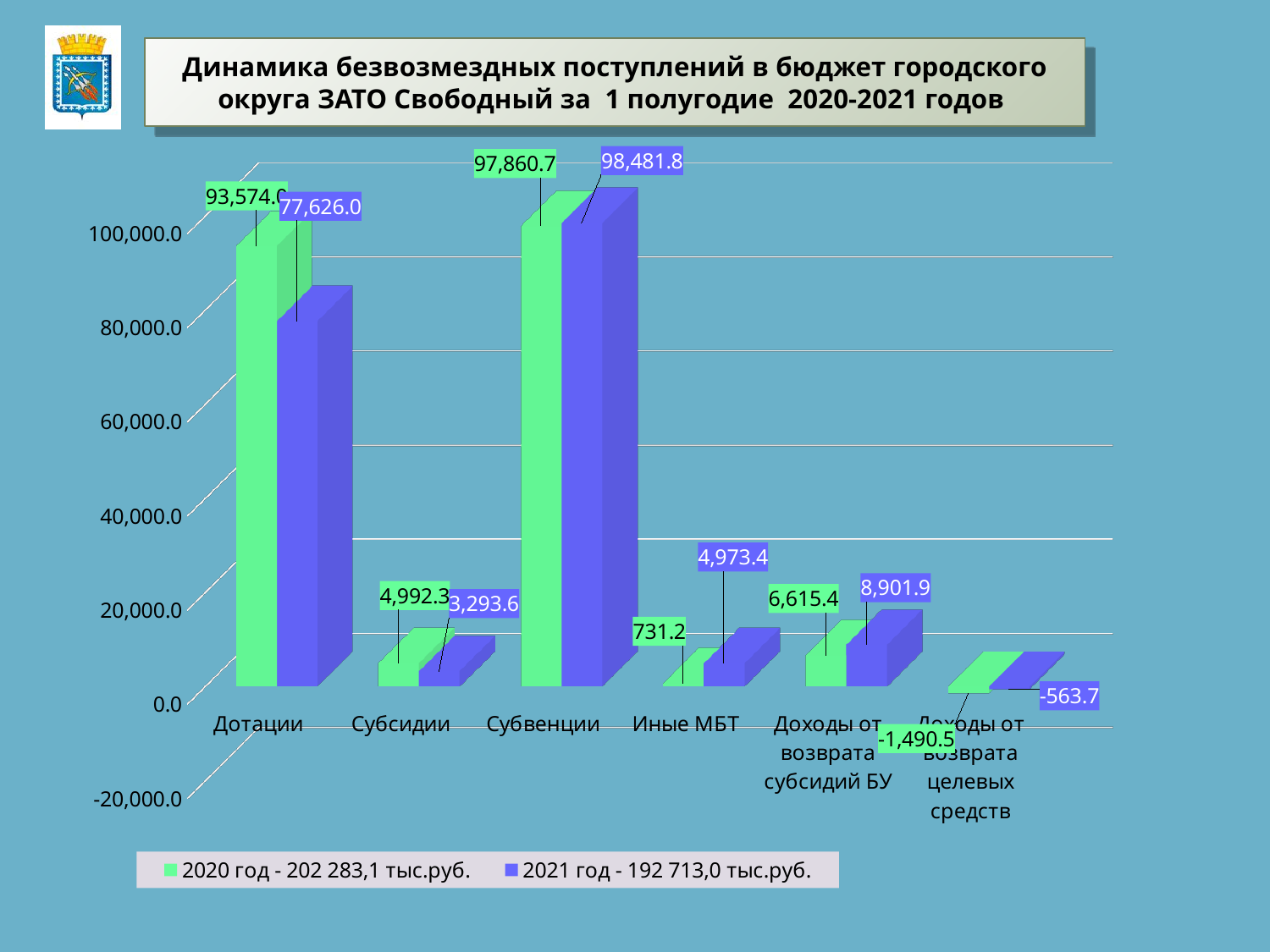
How many series does the legend list? 2 What is the difference between the 2020 and 2021 values for Дотации? 15,948.0 What is the 2020 value for Доходы от возврата целевых средств? -1,490.5 What total amount does the legend give for 2021 год? 192 713,0 тыс.руб. Which category has the lowest 2020 value? Доходы от возврата целевых средств How many categories are shown on the x axis? 6 What is the 2021 value for Иные МБТ? 4,973.4 What is the 2021 value for Субвенции? 98,481.8 What is the 2020 value for Дотации? 93,574.0 What kind of chart is shown on the slide? Bar chart Which is larger for Субсидии, the 2020 value or the 2021 value? 2020 Which category has the highest 2021 value? Субвенции